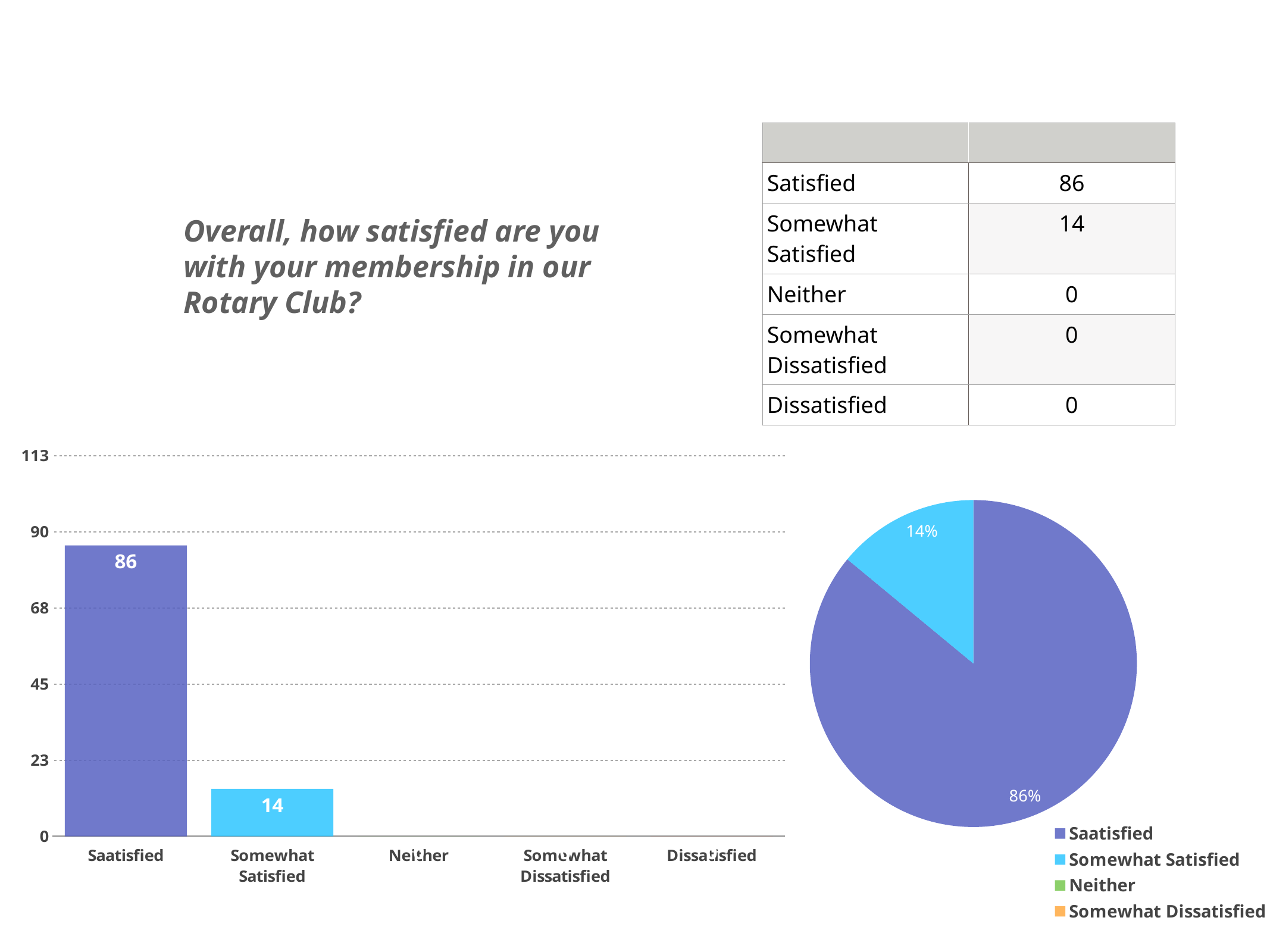
In the bar chart on the left, what is the value for Somewhat Satisfied? 14 What kind of chart is on the right of the slide? pie chart In the pie chart on the right, what share does Saatisfied have? 86% In the bar chart on the left, how many categories are shown on the x axis? 5 In the pie chart on the right, how many entries does the legend list? 4 What kind of chart is on the left of the slide? bar chart In the bar chart on the left, what is the value for Saatisfied? 86 In the bar chart on the left, what is the difference between the Saatisfied and Somewhat Satisfied values? 72 In the bar chart on the left, which category has the highest value? Saatisfied In the pie chart on the right, what share does Somewhat Satisfied have? 14% In the bar chart on the left, which is larger, Saatisfied or Somewhat Satisfied? Saatisfied In the bar chart on the left, is the value for Saatisfied greater or less than 68? greater